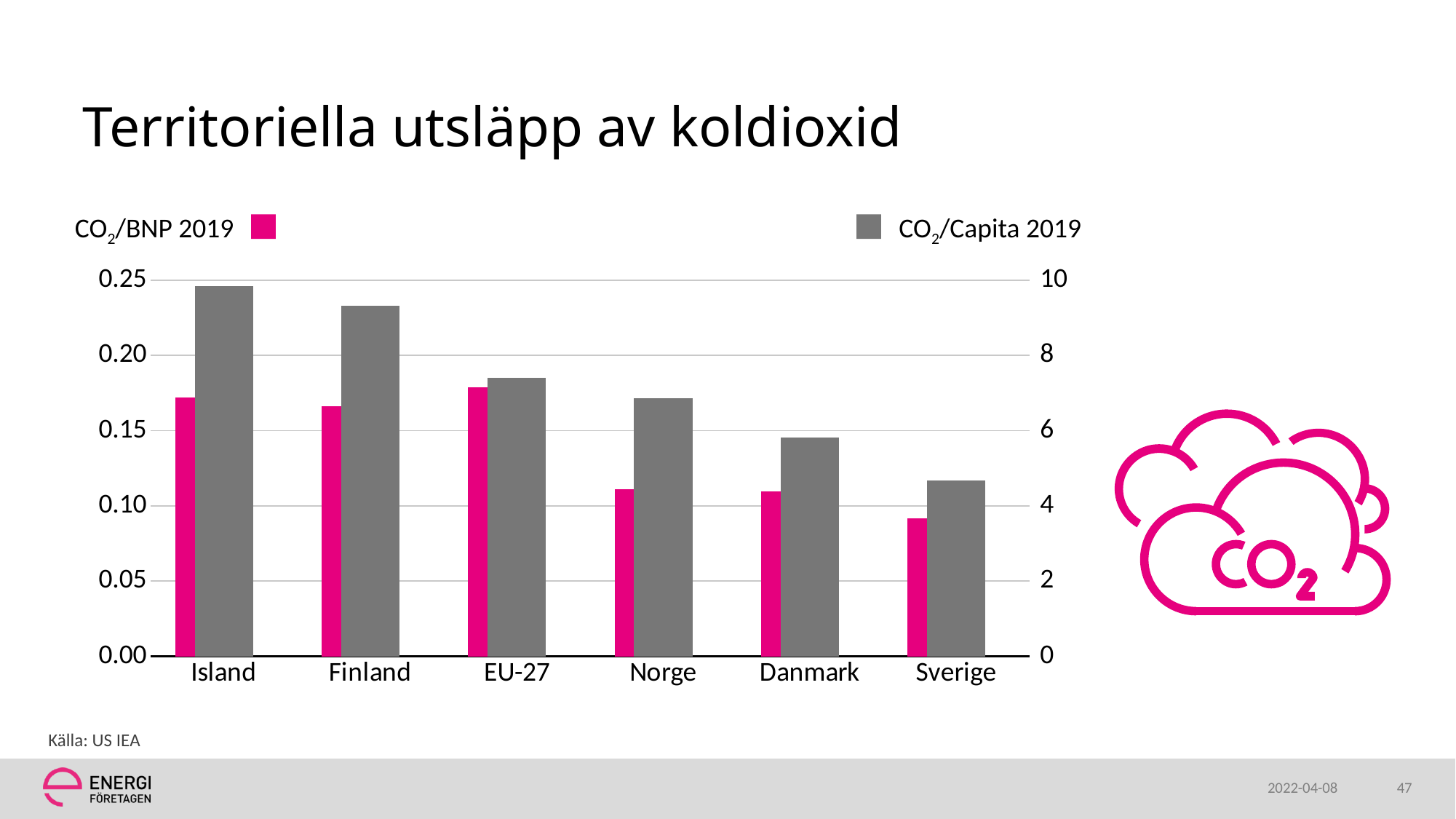
Which has the larger CO2/BNP 2019 value, Finland or Norge? Finland Which category has the highest CO2/Capita 2019 value? Island How many series does the chart's legend list? 2 Which category has the lowest CO2/BNP 2019 value? Sverige Do the CO2/Capita 2019 values rise or fall from left to right along the x axis? fall Is the CO2/BNP 2019 value for Sverige greater or less than 0.10? less Is the CO2/Capita 2019 value for Norge greater or less than 6? greater Is the CO2/Capita 2019 value for Island greater or less than 8? greater Which category has the lowest CO2/Capita 2019 value? Sverige How many countries or regions are shown on the x axis of the chart? 6 What kind of chart is shown on the slide? bar chart